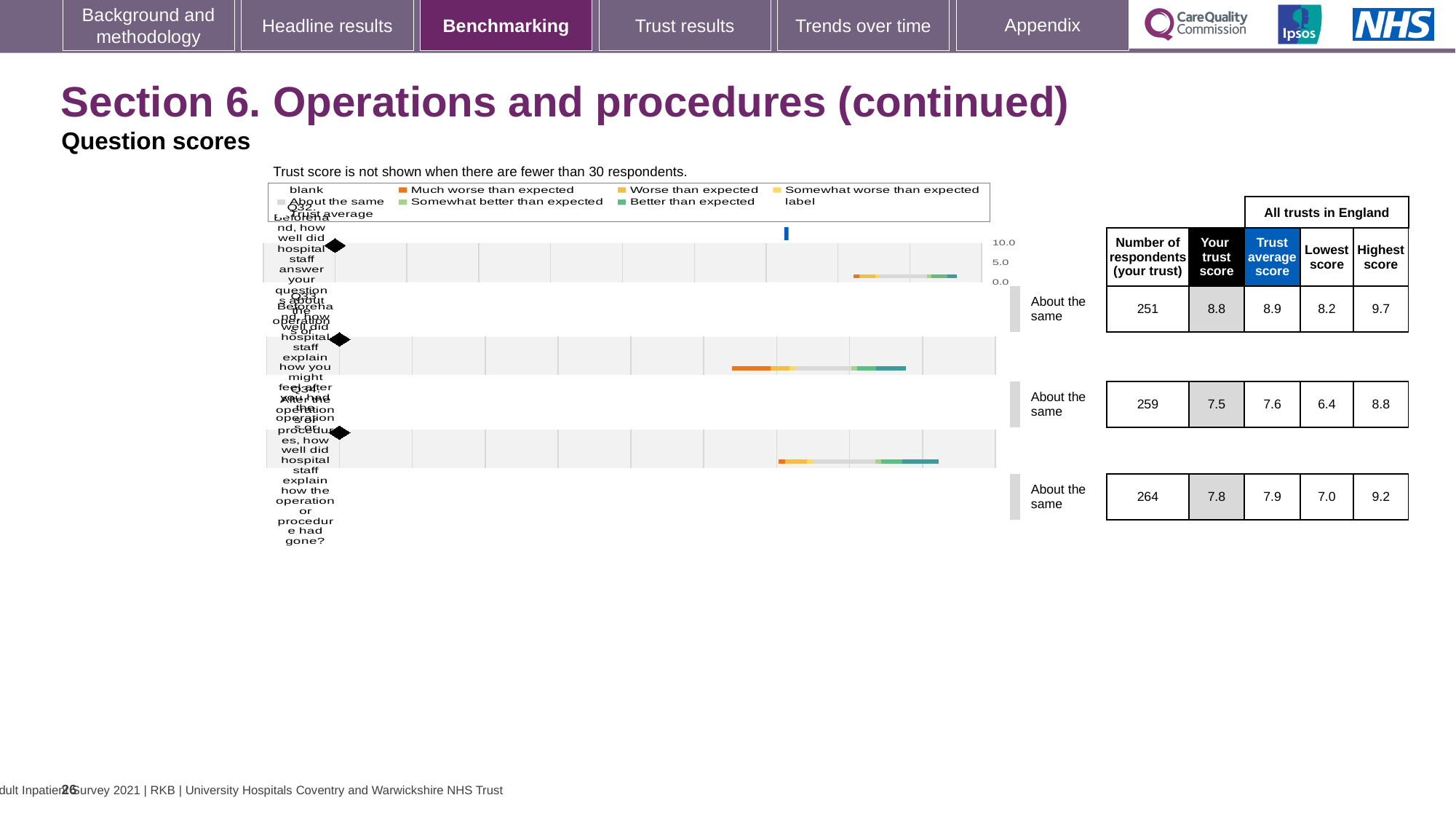
Which of the three questions has the lowest trust score? Q33 What benchmark category is shown next to each of the three question charts? About the same What is the highest score across all trusts in England for Q34 (how well staff explained how the operation or procedure had gone)? 9.2 Which of the three questions has the highest trust score? Q32 Which legend entry is shown in orange? Much worse than expected Is the trust score for Q34 larger or smaller than the trust average score for Q34? smaller What is the difference between the highest score and the lowest score for Q32? 1.5 How many question charts are shown on the slide? 3 What kind of chart is used to show the benchmarking results for each question on this slide? bar chart What is the trust score for Q32 (how well hospital staff answered questions about the operation or procedure)? 8.8 What is the trust average score for Q33 (how well staff explained how you might feel after the operation)? 7.6 How many respondents answered Q33 at this trust? 259